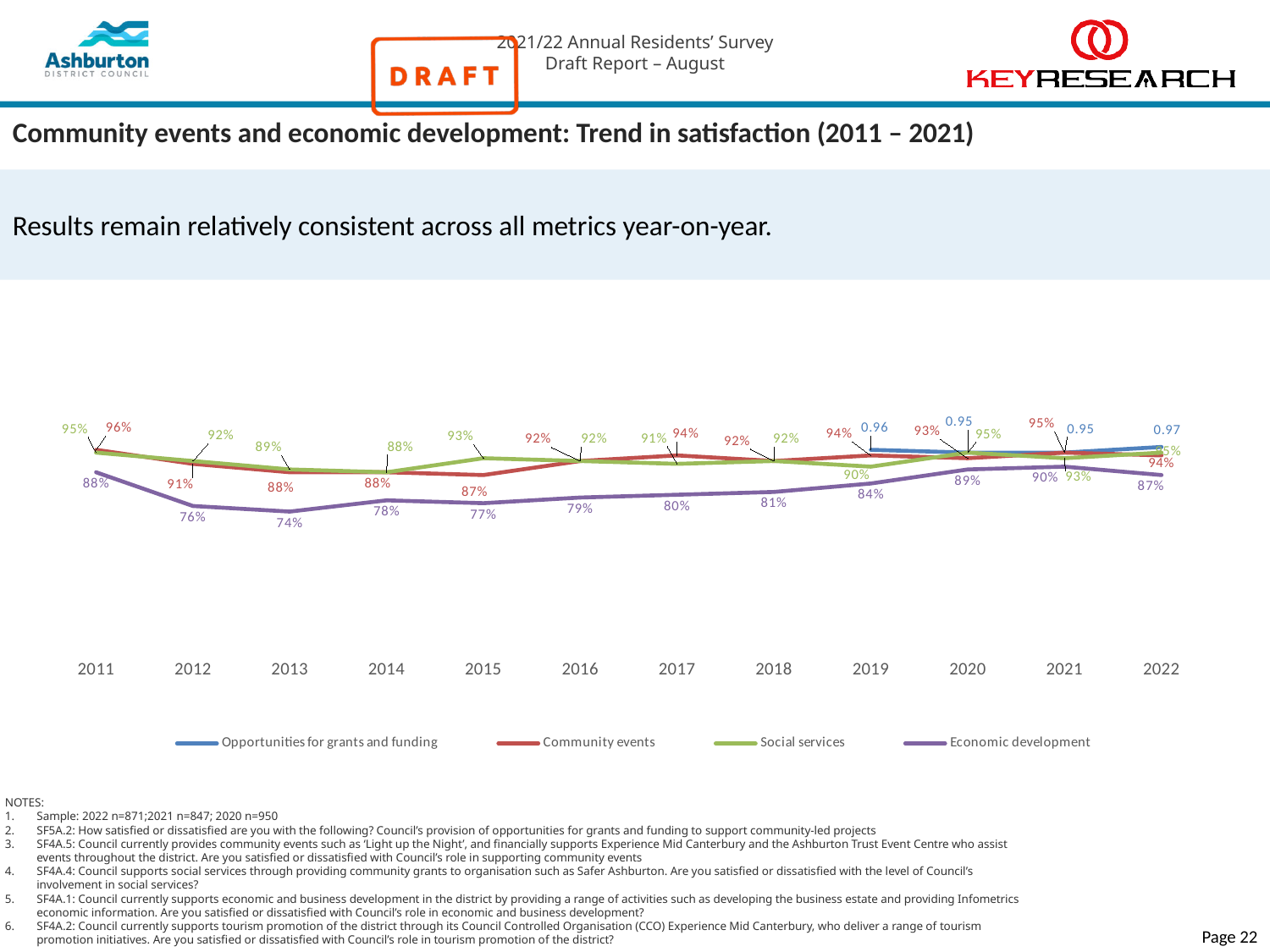
What is the value for Social services in 2020? 95% In 2022, which is higher: Social services or Community events? Social services Does the Economic development line rise or fall from 2013 to 2021? Rise What is the value for Economic development in 2013? 74% In which year is Community events at its highest? 2011 How many series does the legend list? 4 By how many percentage points did Economic development fall from 2011 to 2012? 12 percentage points What is the value for Opportunities for grants and funding in 2022? 0.97 How many years are shown on the x axis of the chart? 12 What kind of chart is shown on the slide? Line chart What is the value for Community events in 2011? 96% In which year is Economic development at its lowest? 2013